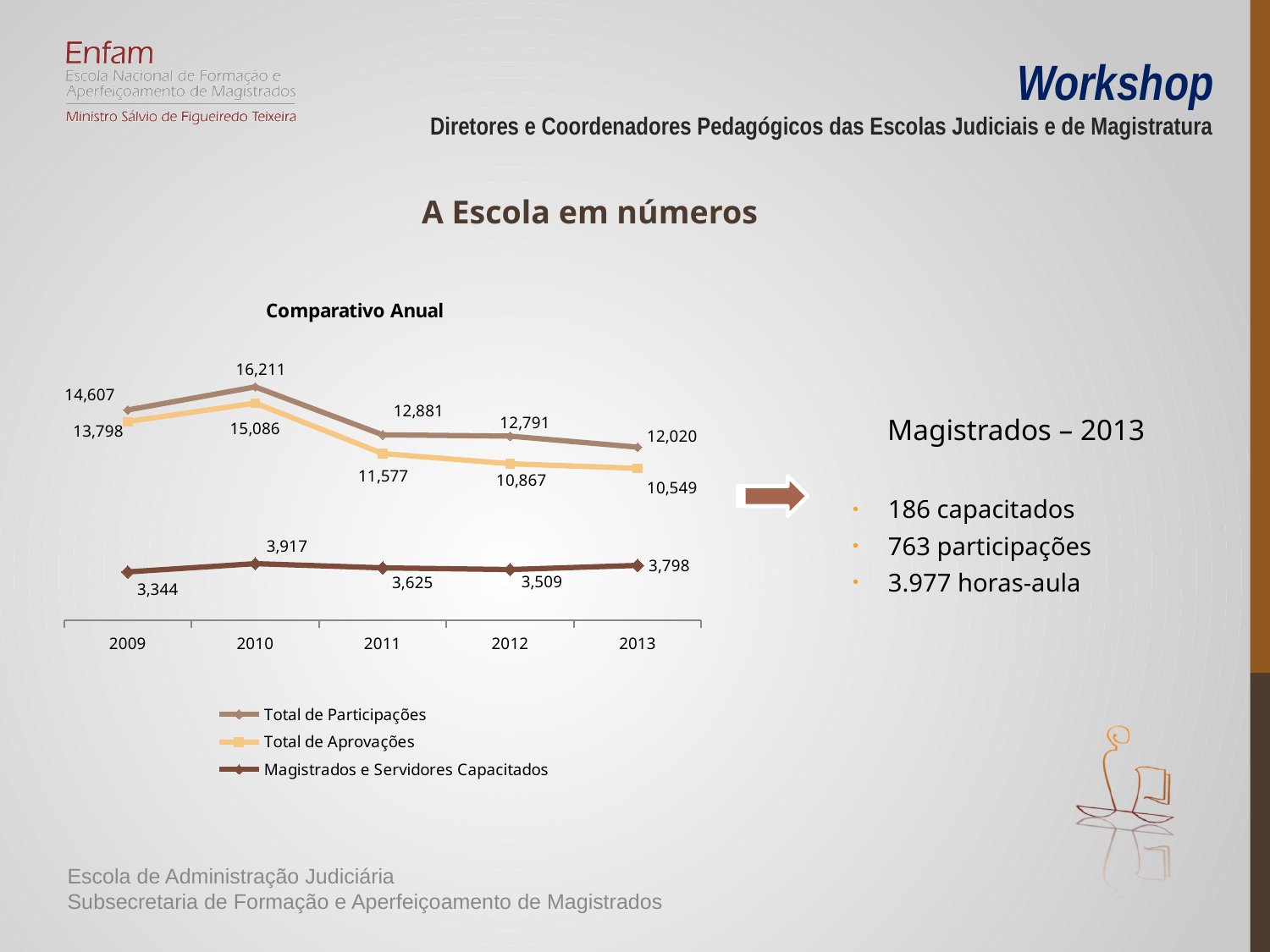
How many years are shown on the x axis of the 'Comparativo Anual' chart? 5 What is the value of 'Magistrados e Servidores Capacitados' in 2009? 3,344 What is the title of the chart on the slide? Comparativo Anual How many series does the legend of the 'Comparativo Anual' chart list? 3 In which year is 'Total de Participações' highest? 2010 What is the value of 'Total de Participações' in 2010? 16,211 What is the value of 'Total de Aprovações' in 2013? 10,549 In which year is 'Magistrados e Servidores Capacitados' lowest? 2009 Does 'Total de Aprovações' rise or fall from 2010 to 2013? fall Which is larger in 2011: 'Total de Aprovações' or 'Magistrados e Servidores Capacitados'? Total de Aprovações What is the difference between 'Total de Participações' and 'Total de Aprovações' in 2012? 1,924 What type of chart is 'Comparativo Anual'? line chart